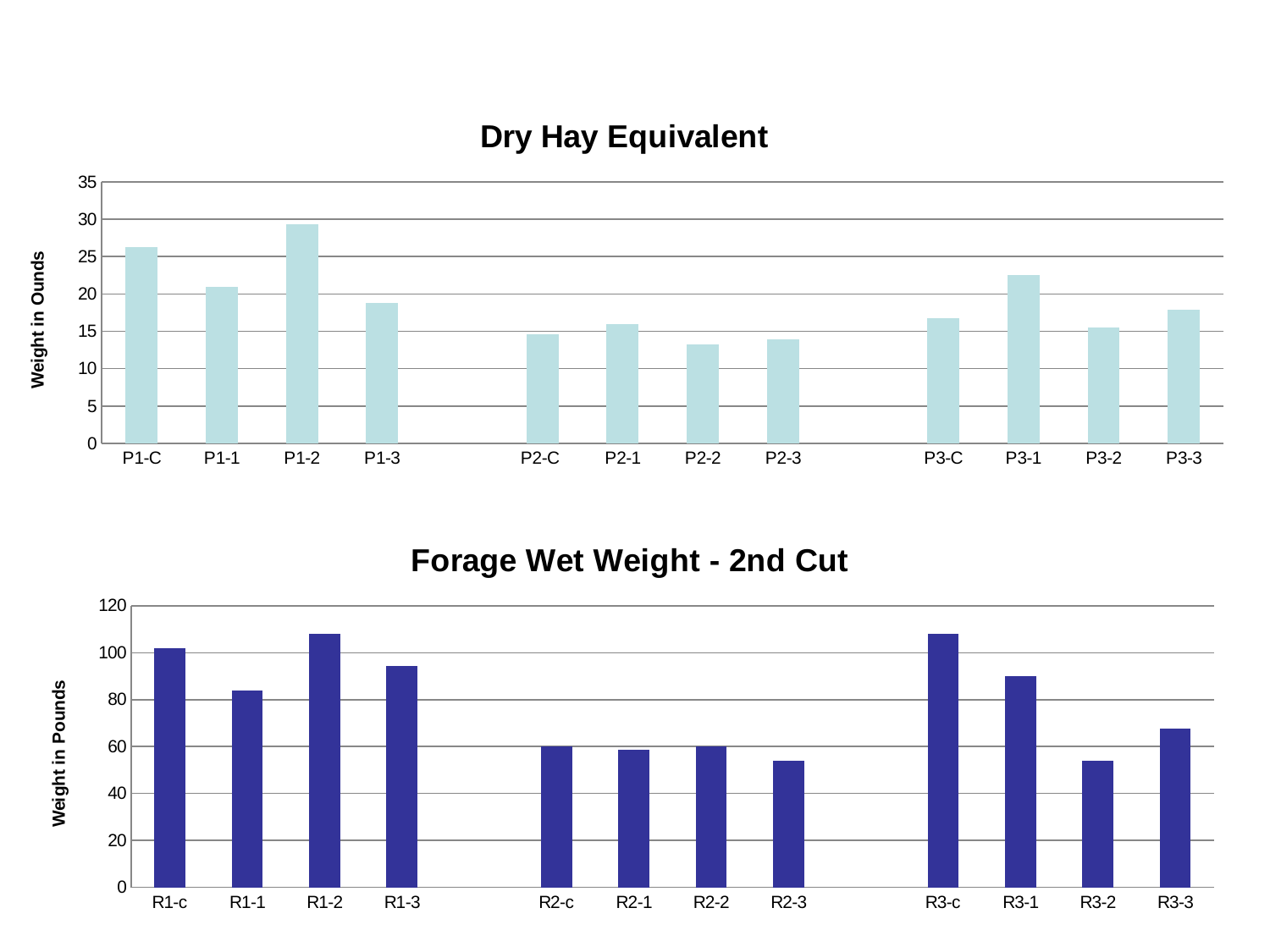
In the Dry Hay Equivalent chart, is the value for P1-C greater or less than 25? greater In the Dry Hay Equivalent chart, which is larger, P3-1 or P3-2? P3-1 How many categories are shown in the Forage Wet Weight - 2nd Cut chart? 12 In the Dry Hay Equivalent chart, is the value for P2-C greater or less than 15? less What is the y-axis label of the Forage Wet Weight - 2nd Cut chart? Weight in Pounds In the Forage Wet Weight - 2nd Cut chart, is the value for R2-3 greater or less than 60? less In the Dry Hay Equivalent chart, which category has the highest value? P1-2 What kind of chart is the Dry Hay Equivalent chart? bar chart In the Dry Hay Equivalent chart, which category has the lowest value? P2-2 In the Forage Wet Weight - 2nd Cut chart, which is larger, R1-1 or R2-1? R1-1 How many categories are shown in the Dry Hay Equivalent chart? 12